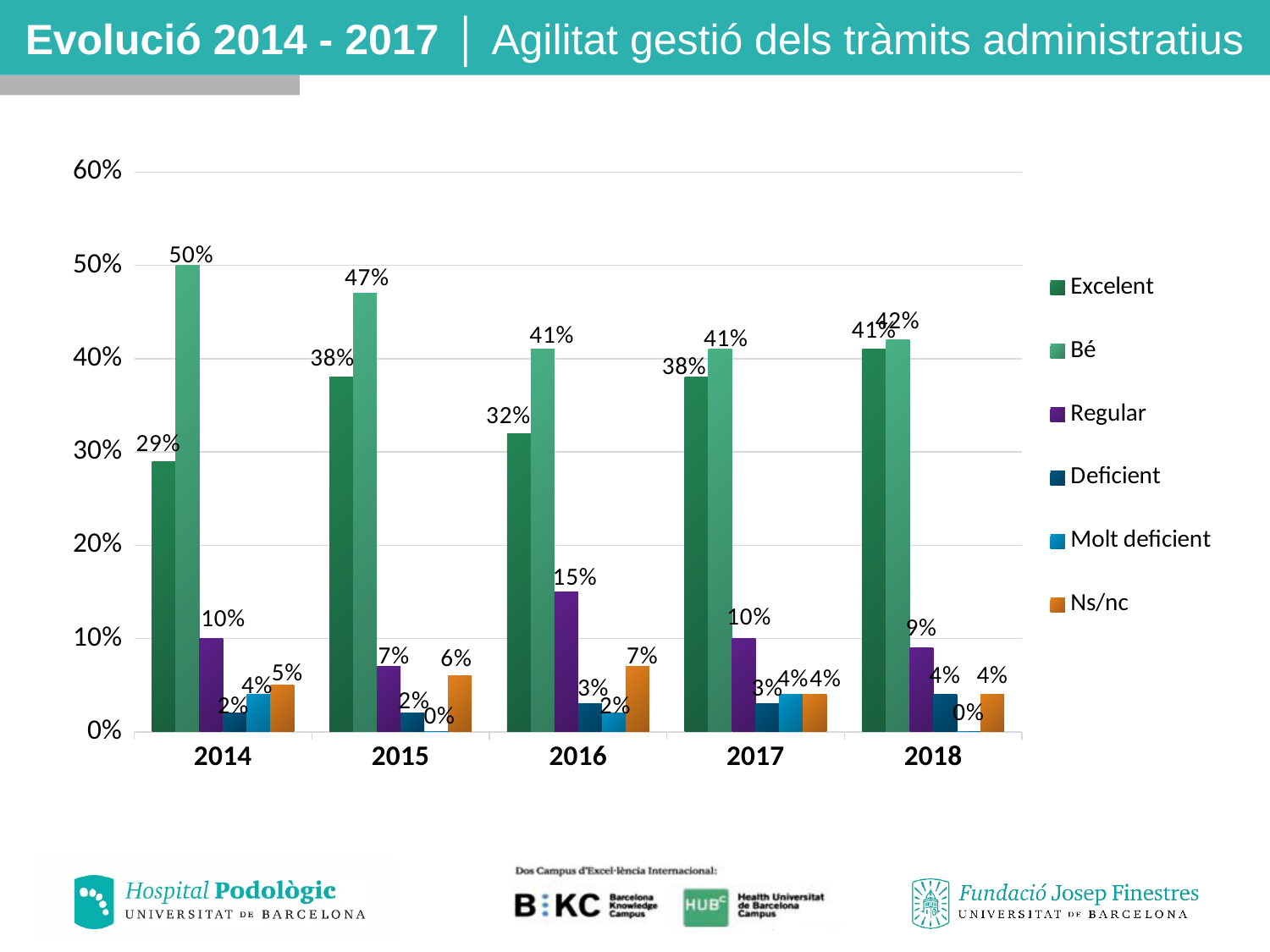
What kind of chart is shown on the slide? Bar chart What is the value for Ns/nc in 2015? 6% What is the value for Bé in 2014? 50% How many years are shown on the x axis? 5 Does the Excelent value rise or fall from 2016 to 2018? Rise How many series does the legend list? 6 In which year is the Excelent value lowest? 2014 In which year is the Bé value highest? 2014 What is the value for Regular in 2016? 15% What is the difference between the Bé and Excelent values in 2015? 9% What is the value for Excelent in 2018? 41% Which is larger in 2017, Excelent or Bé? Bé